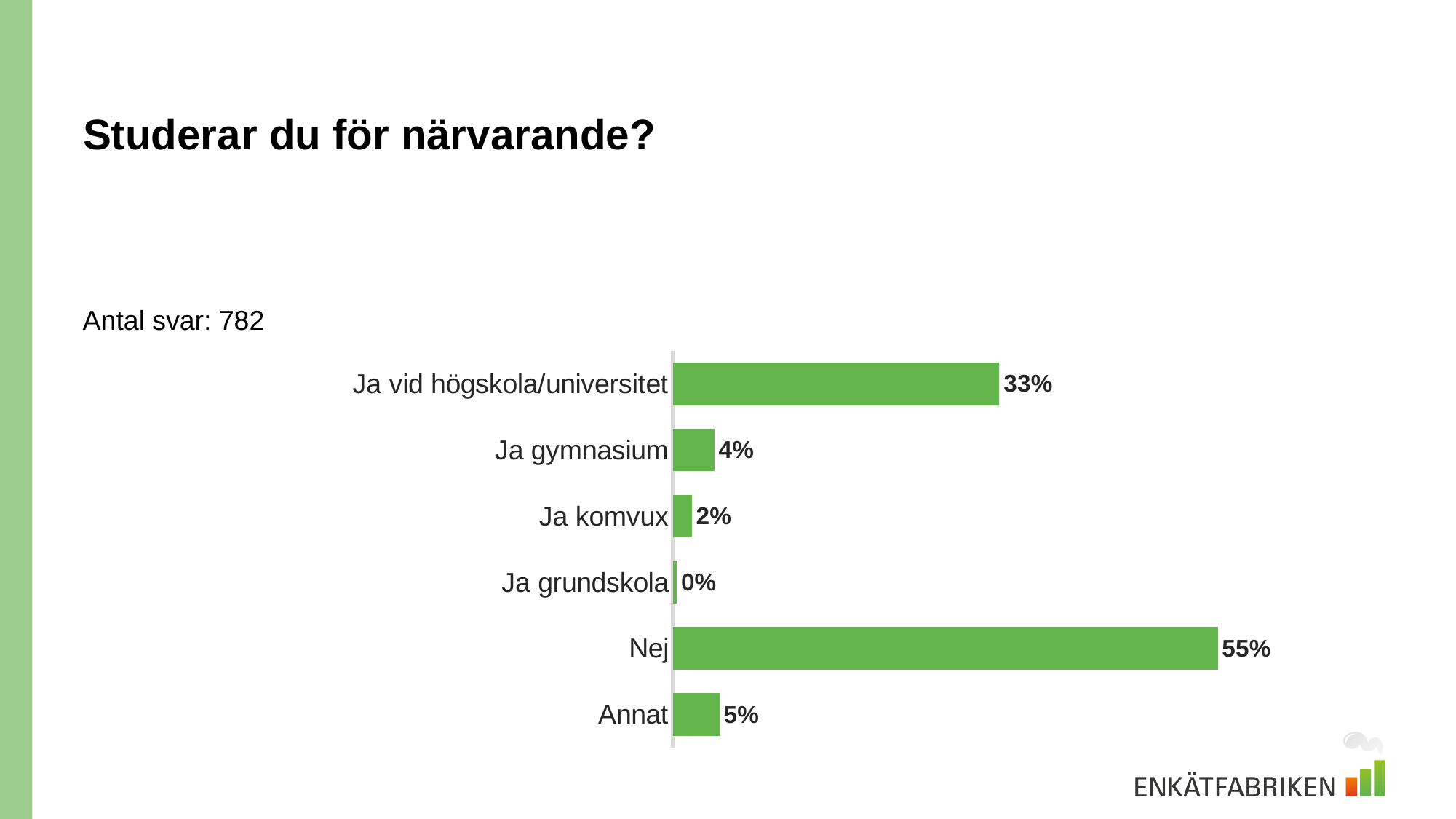
Which category has the highest value? Nej How many responses (Antal svar) does the slide report? 782 How many categories are shown in the chart? 6 What is the value for "Ja vid högskola/universitet"? 33% Which category has the lowest value? Ja grundskola What is the value for "Ja gymnasium"? 4% What is the difference between the values for "Nej" and "Ja vid högskola/universitet"? 22% What is the title of the slide? Studerar du för närvarande? What is the value for "Ja grundskola"? 0% What is the value for "Nej"? 55% Which is larger, the value for "Annat" or the value for "Ja gymnasium"? Annat What kind of chart is shown on the slide? Bar chart